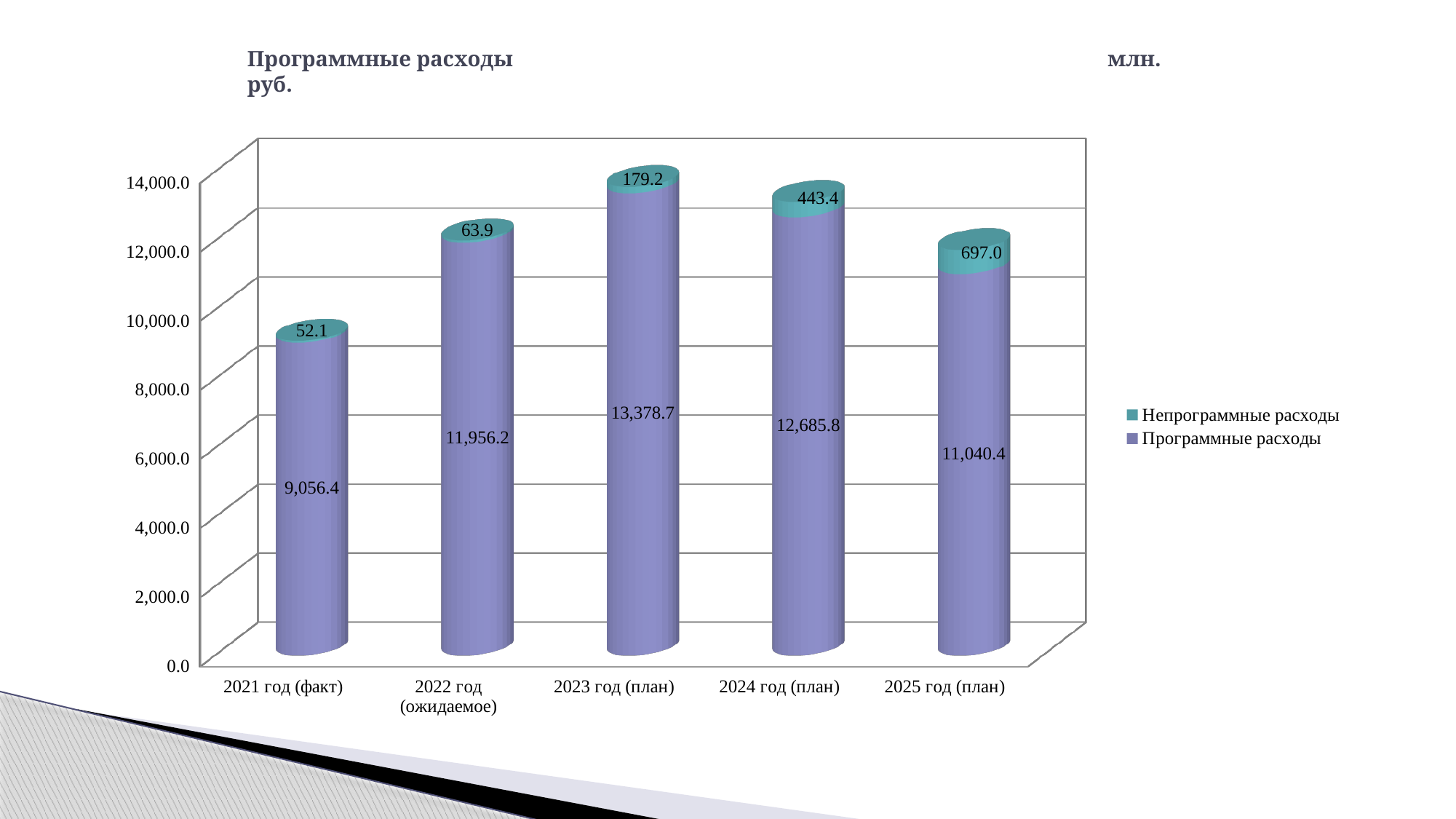
How many series does the legend list? 2 What is the difference in Программные расходы between 2023 год (план) and 2022 год (ожидаемое)? 1,422.5 What is the value of Непрограммные расходы for 2025 год (план)? 697.0 Which is larger: Непрограммные расходы in 2024 год (план) or in 2025 год (план)? 2025 год (план) What is the total of the stacked bar for 2024 год (план)? 13,129.2 Which series is shown in teal in the legend? Непрограммные расходы How many year categories are shown on the x axis? 5 Which year has the highest value of Программные расходы? 2023 год (план) What is the value of Программные расходы for 2021 год (факт)? 9,056.4 Which year has the lowest value of Непрограммные расходы? 2021 год (факт) What is the value of Программные расходы for 2023 год (план)? 13,378.7 What kind of chart is shown on the slide? Stacked bar chart